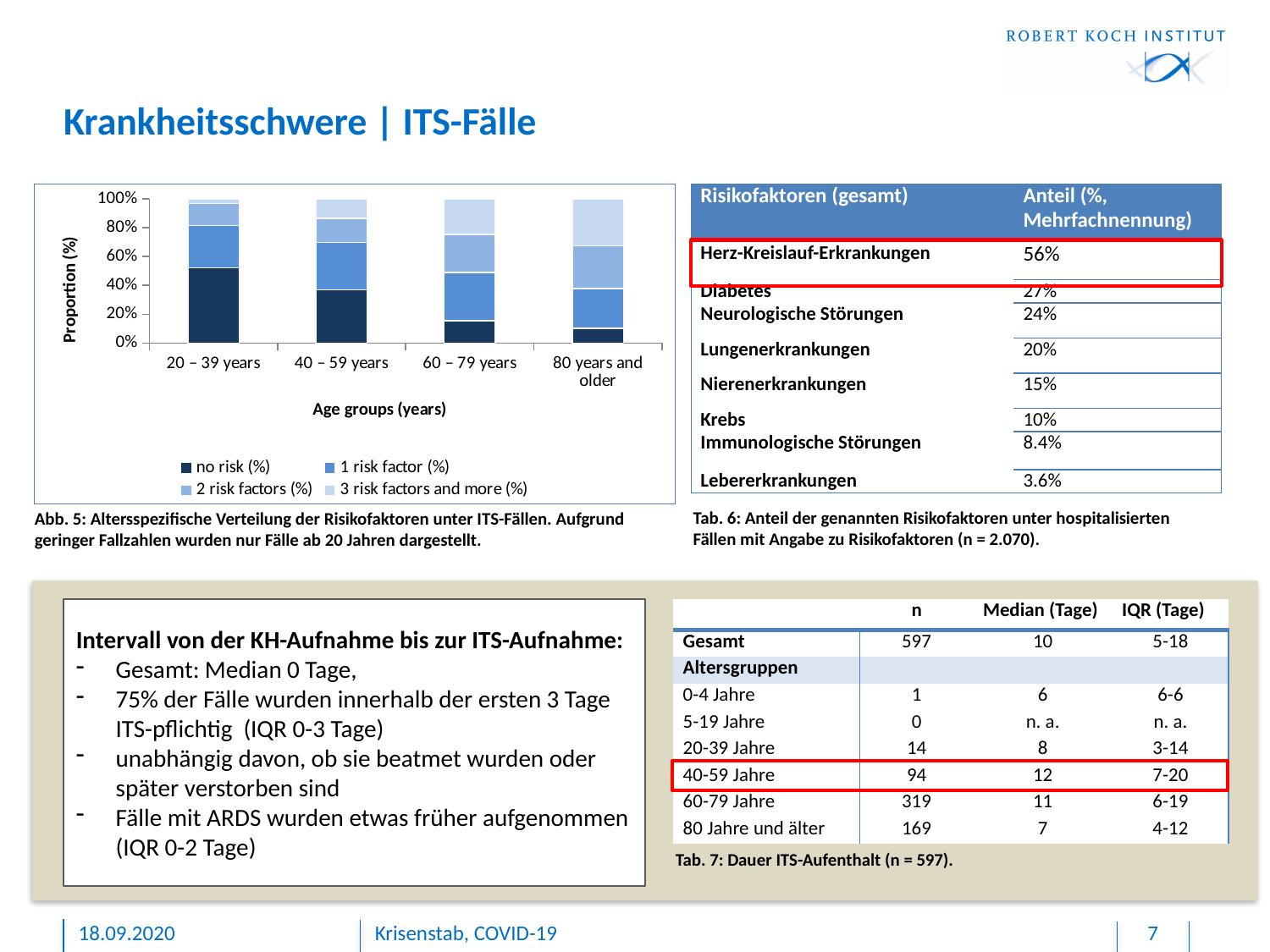
How many series does the chart legend list? 4 Is the 'no risk (%)' value for 80 years and older greater or less than 20%? less Which age group has the smallest 'no risk (%)' share in the chart? 80 years and older How many age groups are shown on the x axis of the chart? 4 What is the title of the y axis of the chart? Proportion (%) Is the 'no risk (%)' share larger for 40 – 59 years or for 60 – 79 years? 40 – 59 years What kind of chart is shown on the left of the slide? stacked bar chart Does the 'no risk (%)' share rise or fall as the age groups get older along the x axis? fall Is the 'no risk (%)' value for 20 – 39 years greater or less than 40%? greater Which age group has the largest 'no risk (%)' share in the chart? 20 – 39 years What is the title of the x axis of the chart? Age groups (years) Which age group has the largest '3 risk factors and more (%)' share in the chart? 80 years and older